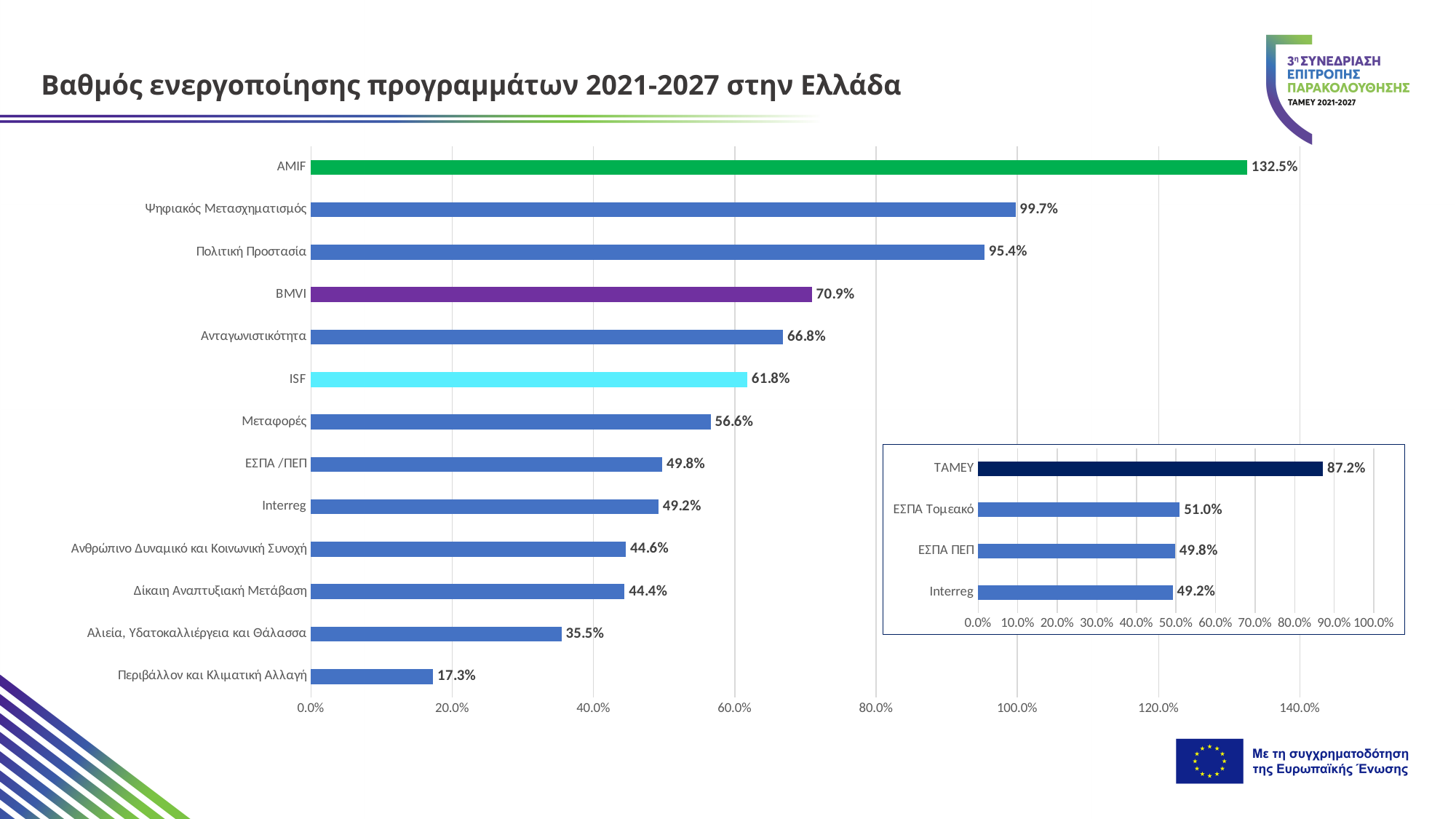
In the large chart on the left, which category has the highest value? AMIF In the large chart on the left, which is larger: the value for BMVI or the value for ISF? BMVI In the small inset chart on the right, which category has the lowest value? Interreg In the large chart on the left, which category has the lowest value? Περιβάλλον και Κλιματική Αλλαγή In the large chart on the left, what is the value for Περιβάλλον και Κλιματική Αλλαγή? 17.3% In the small inset chart on the right, how many categories are plotted? 4 In the small inset chart on the right, what is the difference between the values for ΤΑΜΕΥ and ΕΣΠΑ Τομεακό? 36.2% What kind of chart is the large chart on the left? Bar chart In the large chart on the left, what is the difference between the values for Ψηφιακός Μετασχηματισμός and Πολιτική Προστασία? 4.3% In the large chart on the left, how many categories are plotted? 13 In the large chart on the left, what is the value for AMIF? 132.5% In the small inset chart on the right, what is the value for ΤΑΜΕΥ? 87.2%